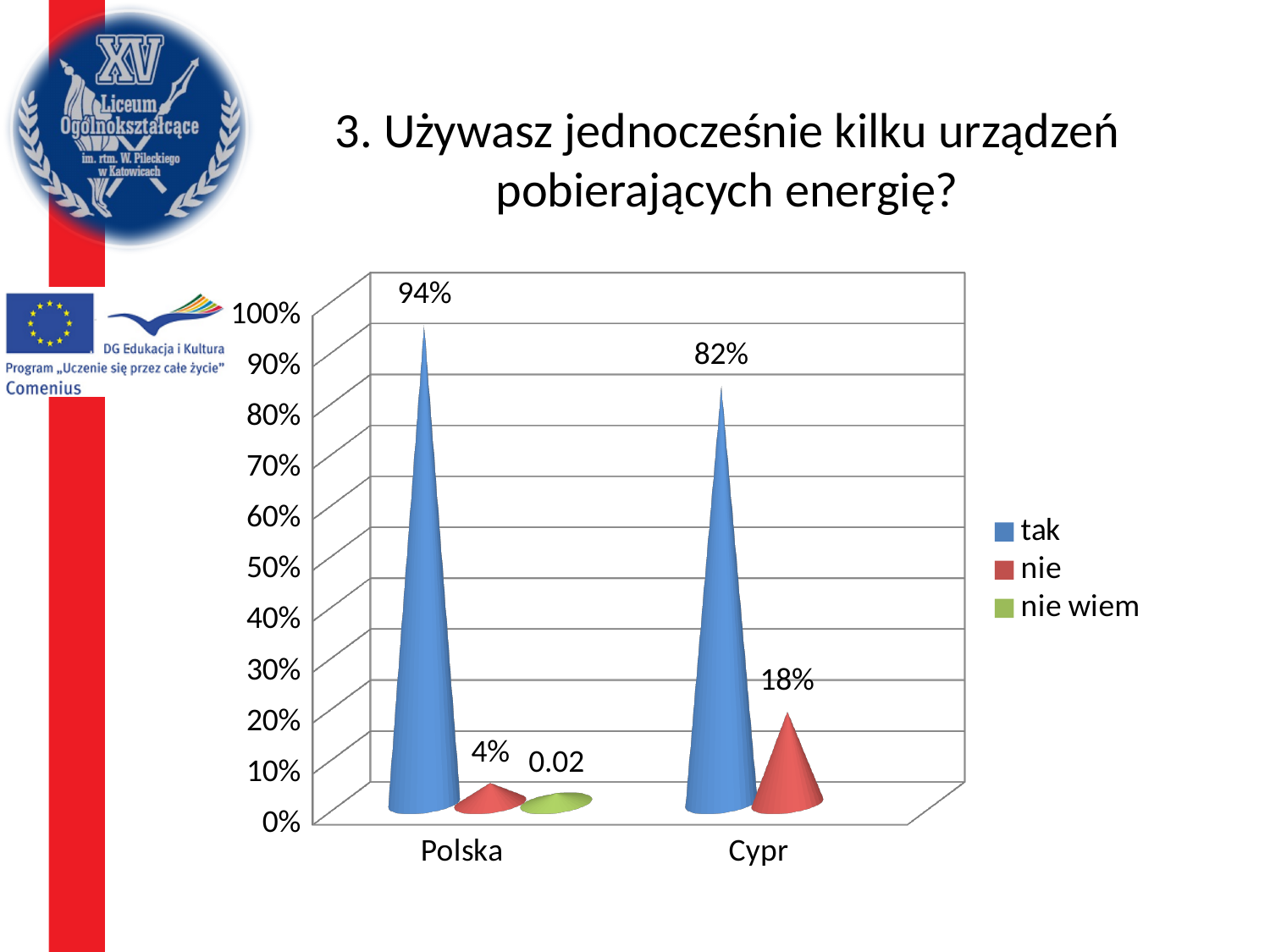
How many countries are shown on the x axis? 2 What colour represents the "nie" series? Red What is the value for "tak" in Polska? 94% Which country has the higher value for "nie"? Cypr What is the difference between the "tak" values for Polska and Cypr? 12% What is the difference between the "nie" values for Cypr and Polska? 14% What is the value for "tak" in Cypr? 82% Which country has the higher value for "tak"? Polska What is the data label shown for "nie wiem" in Polska? 0.02 What is the value for "nie" in Cypr? 18% What is the value for "nie" in Polska? 4% How many series does the legend list? 3